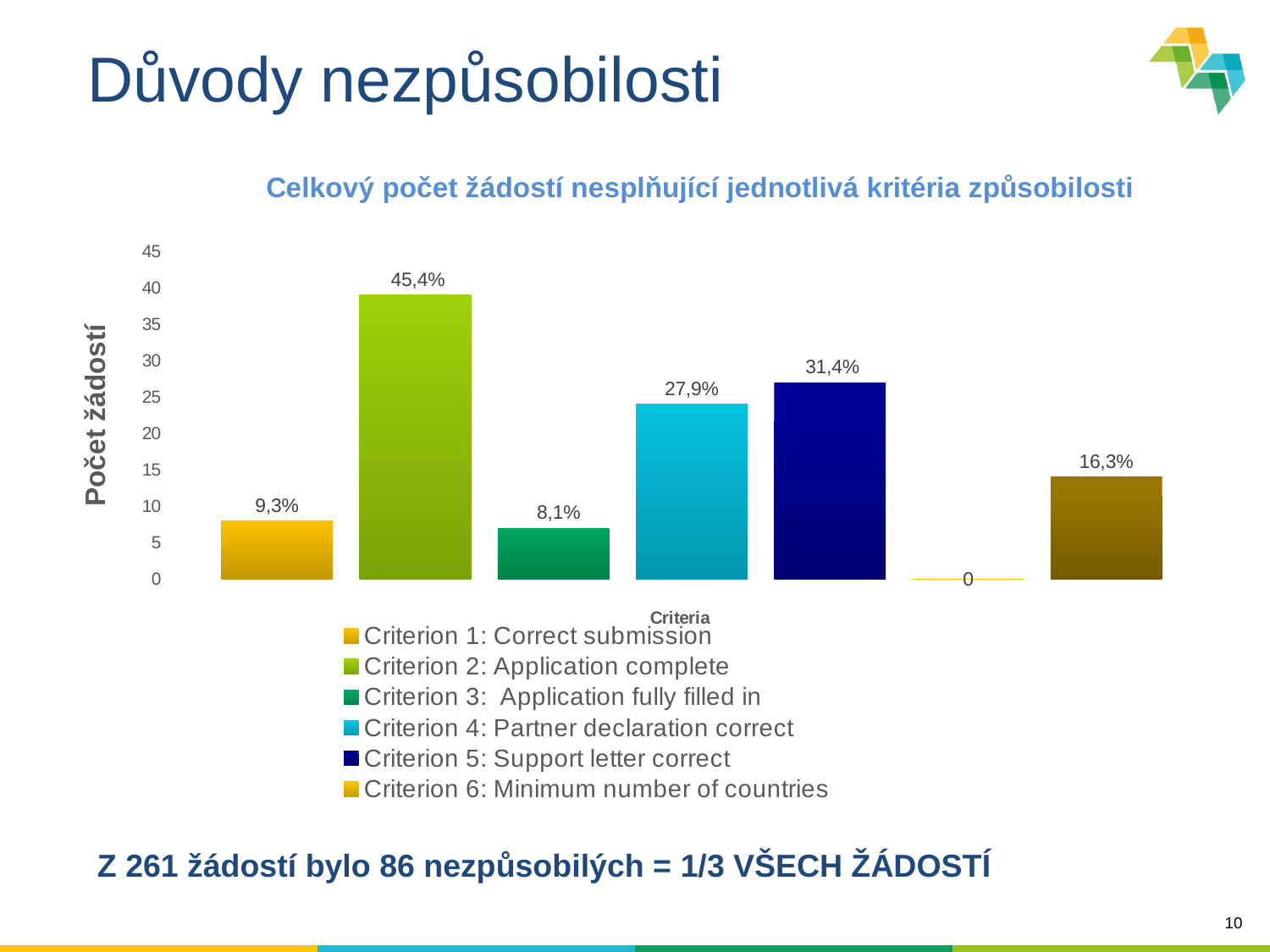
How many entries does the chart legend list? 6 What data label is shown on the first (leftmost) bar? 9,3% How many bars are plotted in the chart? 7 Which bar is the lowest in the chart? The sixth bar, labelled 0 Which bar is the tallest in the chart? The second (green) bar, labelled 45,4% What data label is shown on the third bar? 8,1% What data label is shown on the tallest bar? 45,4% Which is larger, the fourth bar (27,9%) or the fifth bar (31,4%)? The fifth bar (31,4%) What is the title of the y axis? Počet žádostí What data label is shown on the last (rightmost) bar? 16,3% What type of chart is shown on the slide? Bar chart Is the value of the first bar greater or less than 10 on the y axis? less